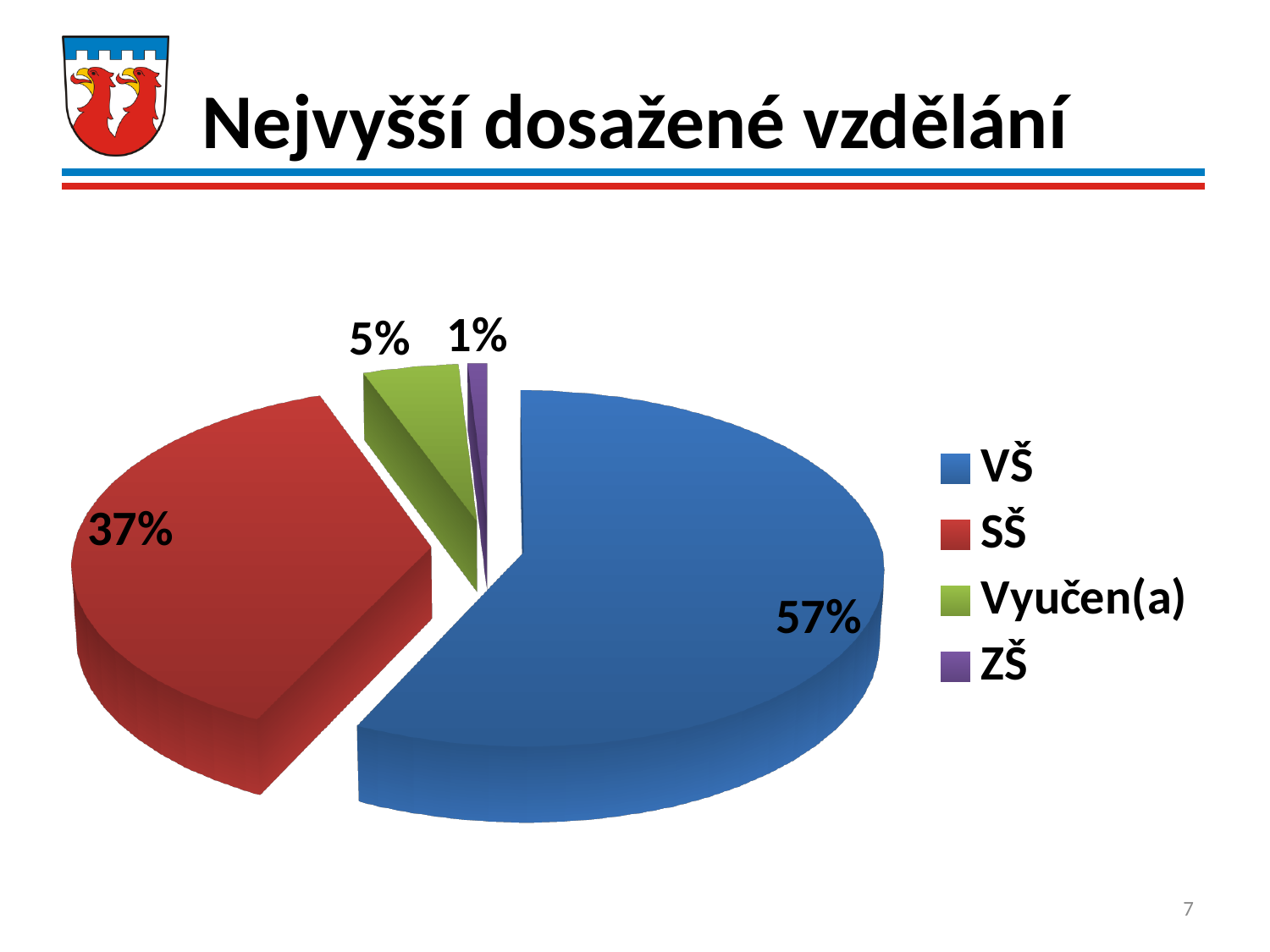
What share of the pie does Vyučen(a) have? 5% Which is larger, the share for SŠ or the share for Vyučen(a)? SŠ What is the difference in percentage points between Vyučen(a) and ZŠ? 4 What is the title of the slide containing the chart? Nejvyšší dosažené vzdělání What share of the pie does SŠ have? 37% Which category has the smallest slice of the pie? ZŠ How many categories does the pie chart show? 4 What share of the pie does VŠ have? 57% What kind of chart is shown on the slide? pie chart What is the difference in percentage points between VŠ and SŠ? 20 Which category has the largest slice of the pie? VŠ